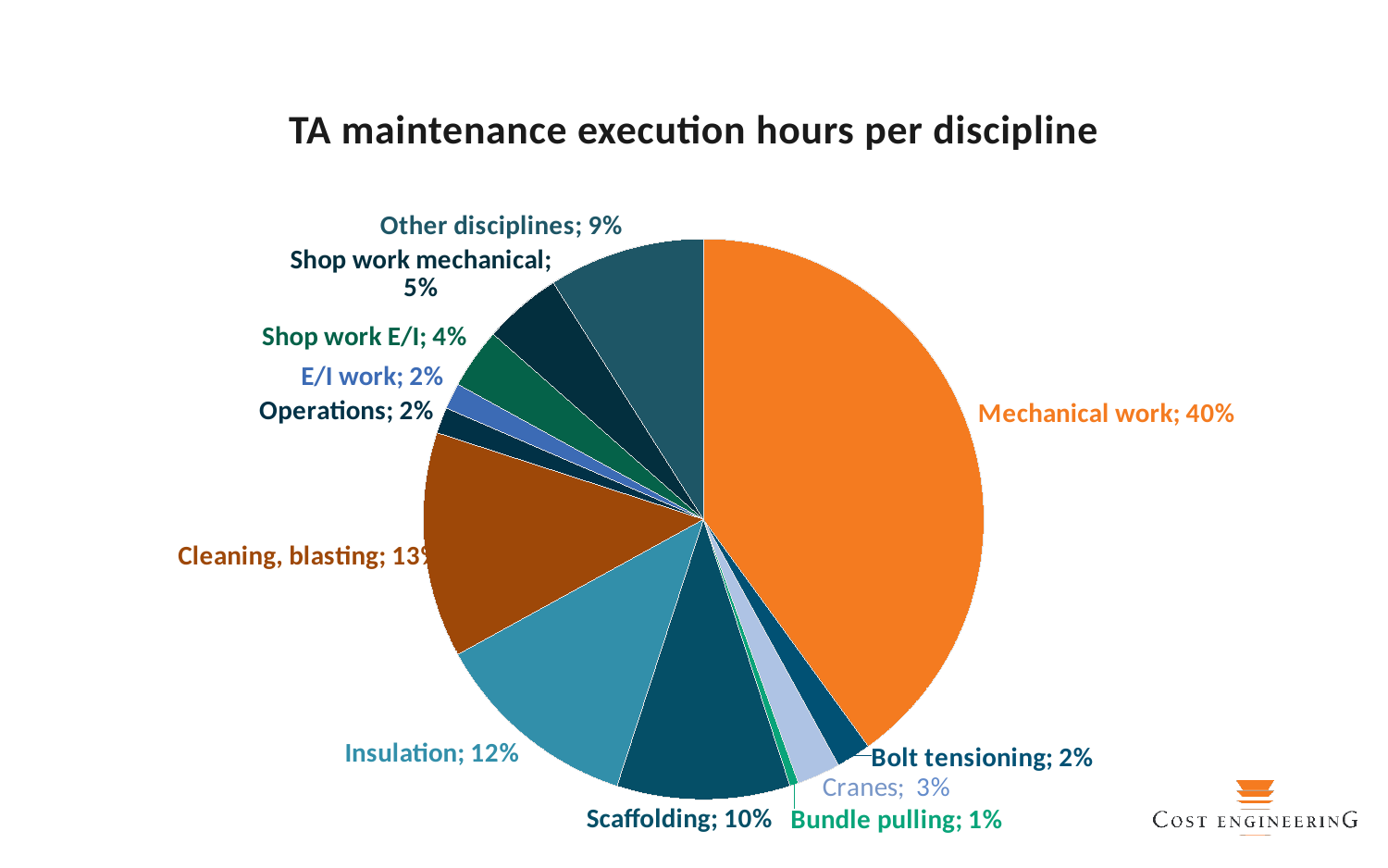
How many disciplines (slices) are shown in the pie chart? 12 What kind of chart is shown on the slide? Pie chart What share of TA maintenance execution hours is Mechanical work? 40% Which discipline has the smallest share of the pie? Bundle pulling Which discipline has the largest share of the pie? Mechanical work What is the difference in percentage points between Mechanical work and Cleaning, blasting? 27 What percentage is shown for Bundle pulling? 1% What percentage is shown for Insulation? 12% What percentage is shown for Cleaning, blasting? 13% What is the title of the chart? TA maintenance execution hours per discipline What percentage is shown for Scaffolding? 10% Which has a larger share, Shop work mechanical or Shop work E/I? Shop work mechanical